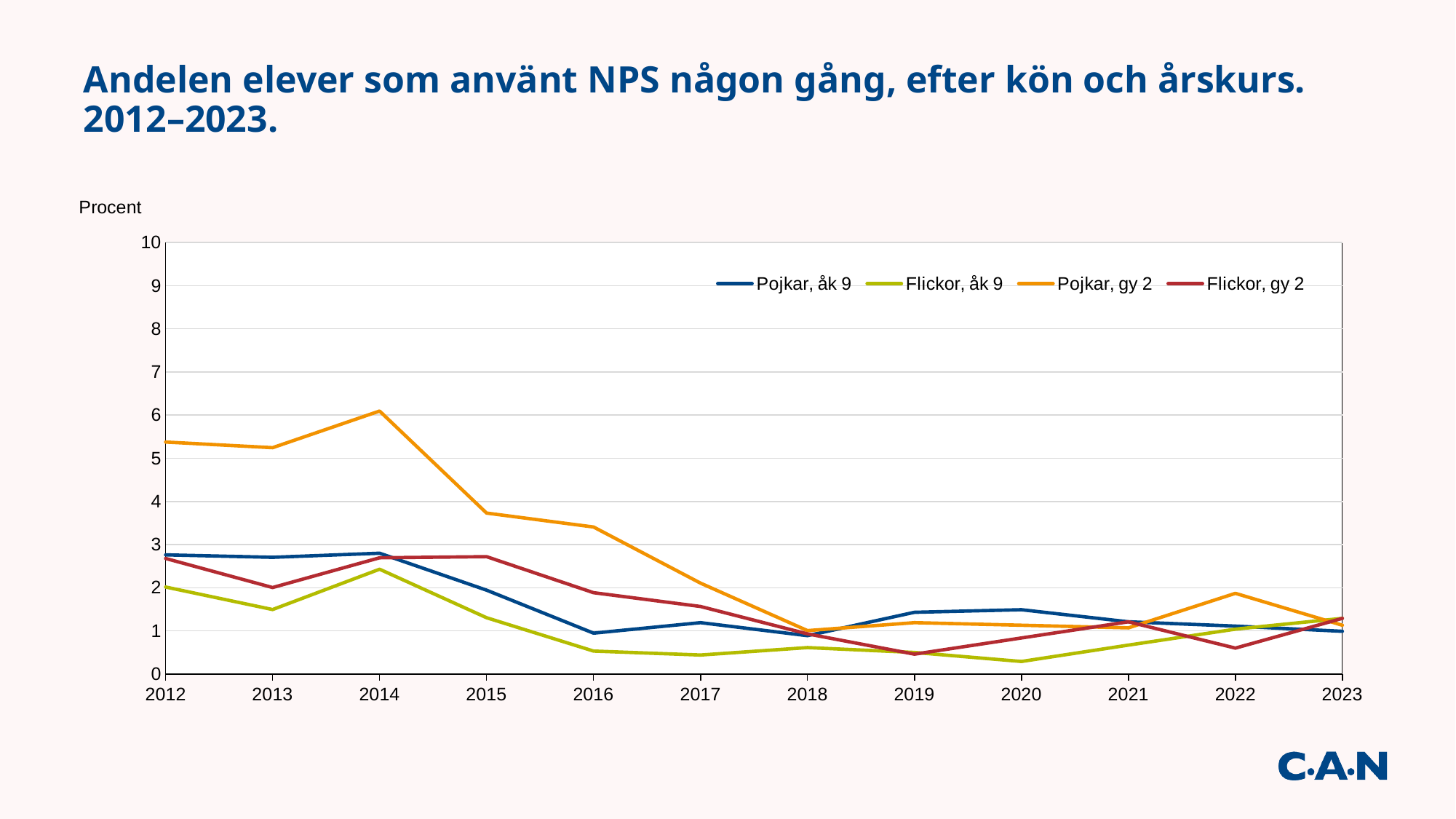
What is the label on the vertical axis? Procent Does the Pojkar, gy 2 series rise or fall between 2014 and 2018? fall How many years are plotted along the x axis? 12 Which series are listed in the legend? Pojkar, åk 9; Flickor, åk 9; Pojkar, gy 2; Flickor, gy 2 Which series has the highest value in 2014? Pojkar, gy 2 Is the value for Pojkar, gy 2 in 2014 greater or less than 5? greater Is the value for Flickor, åk 9 in 2020 greater or less than 1? less What kind of chart is shown on the slide? line chart In 2012, which is larger: Pojkar, gy 2 or Flickor, åk 9? Pojkar, gy 2 In which year does the Pojkar, gy 2 series reach its highest value? 2014 How many series does the legend list? 4 Which series has the lowest value in 2016? Flickor, åk 9